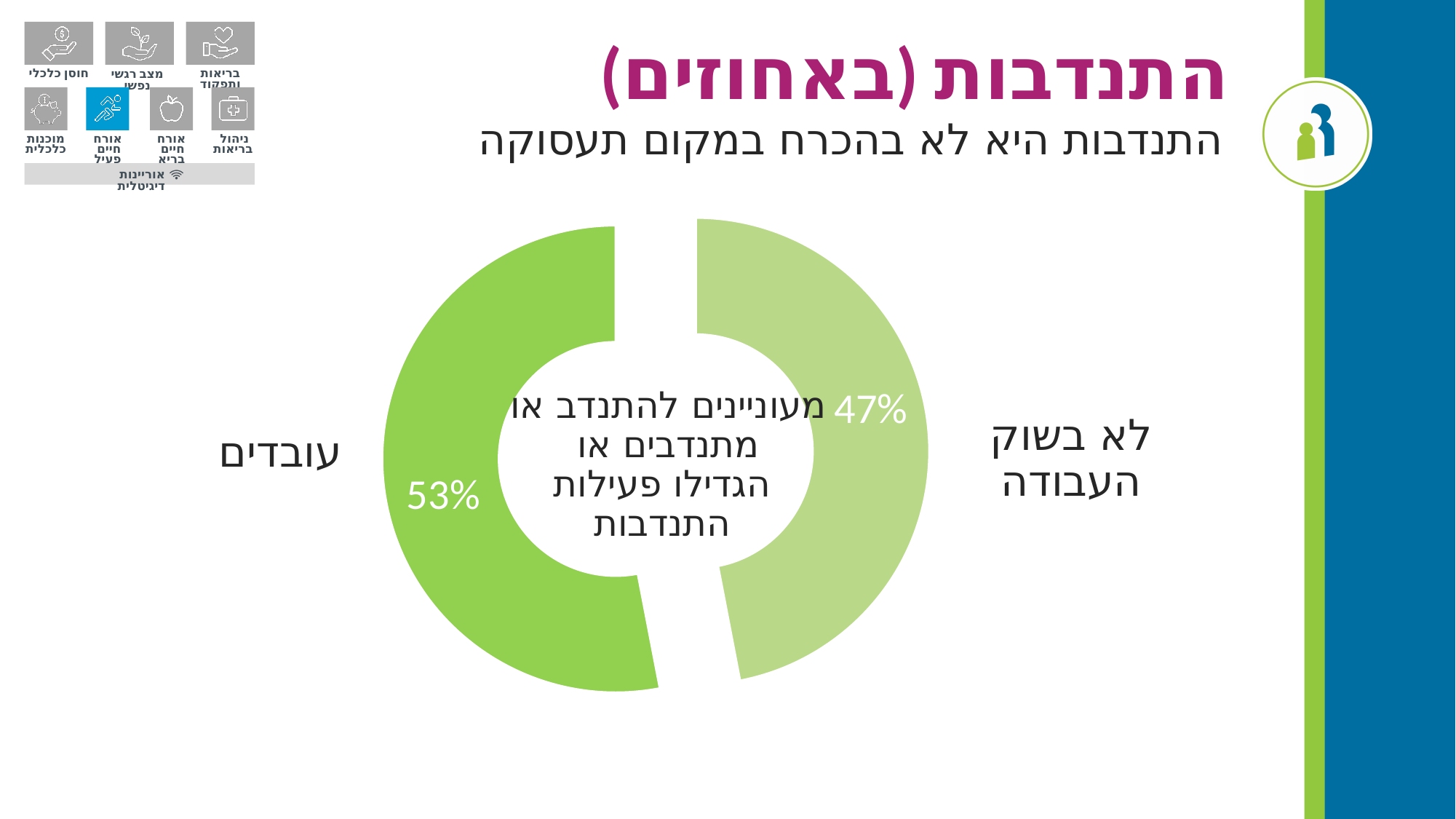
Which segment of the chart is the largest? עובדים Which segment of the chart is the smallest? לא בשוק העבודה Is the value for עובדים greater or less than 50%? greater What is the difference in percentage points between the עובדים segment and the לא בשוק העבודה segment? 6 What kind of chart is shown on the slide? Pie (donut) chart How many segments does the chart have? 2 What is the value shown for the segment labelled לא בשוק העבודה? 47% What text appears in the centre of the donut chart? מעוניינים להתנדב או מתנדבים או הגדילו פעילות התנדבות Which segment has the larger share, עובדים or לא בשוק העבודה? עובדים What is the value shown for the segment labelled עובדים? 53% What is the title of the slide containing the chart? התנדבות (באחוזים)